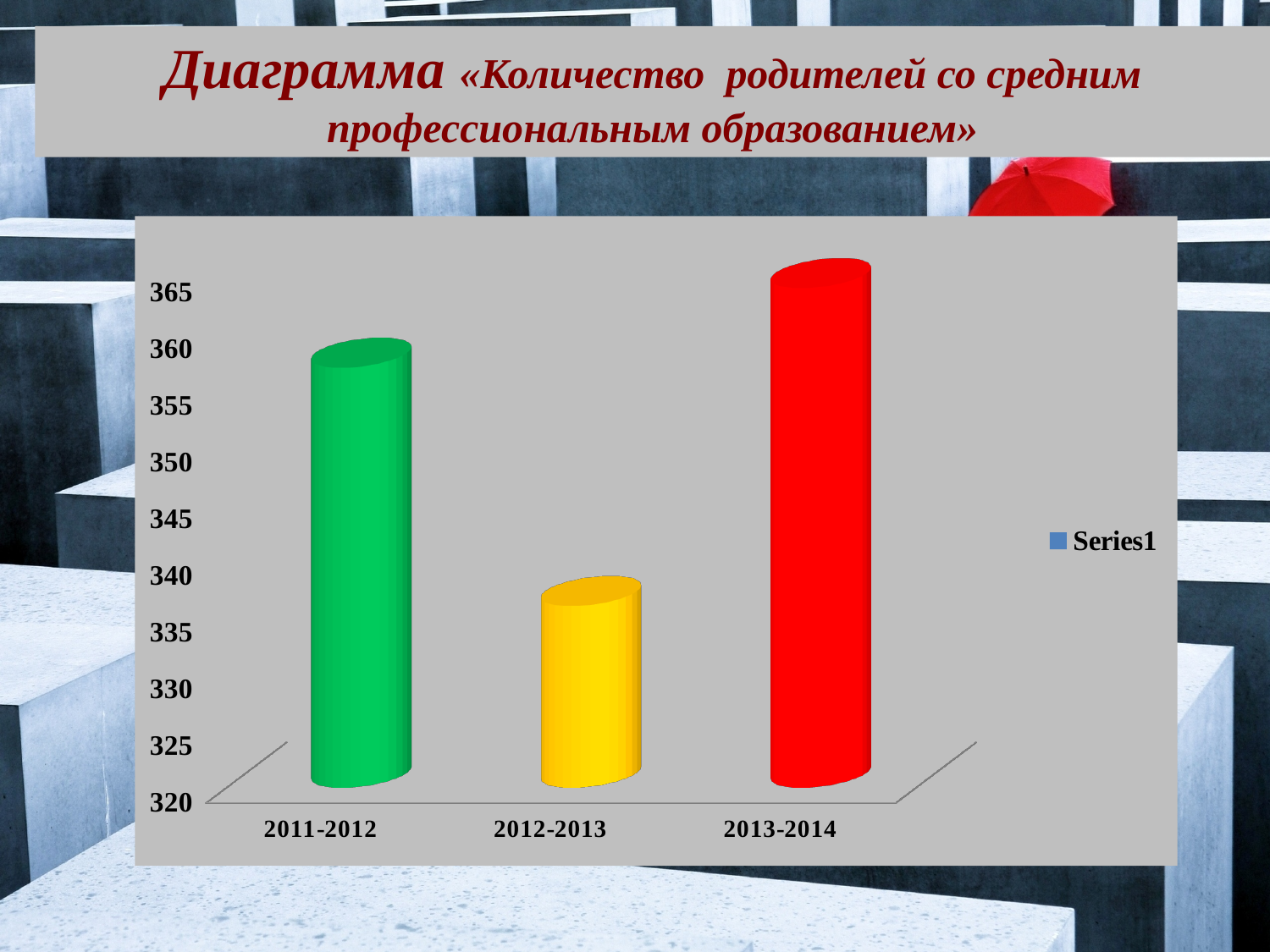
What kind of chart is shown on the slide? bar chart What is the name of the series listed in the legend? Series1 Is the value for 2012-2013 greater or less than 340? less Is the value for 2011-2012 greater or less than 355? greater Which category has the highest value? 2013-2014 What colour is the bar for 2013-2014? red Is the value for 2013-2014 greater or less than 360? greater How many series does the legend list? 1 How many categories are shown on the x axis of the chart? 3 Which category has the lowest value? 2012-2013 Which is larger, the value for 2011-2012 or the value for 2012-2013? 2011-2012 Do the values rise or fall from 2012-2013 to 2013-2014? rise